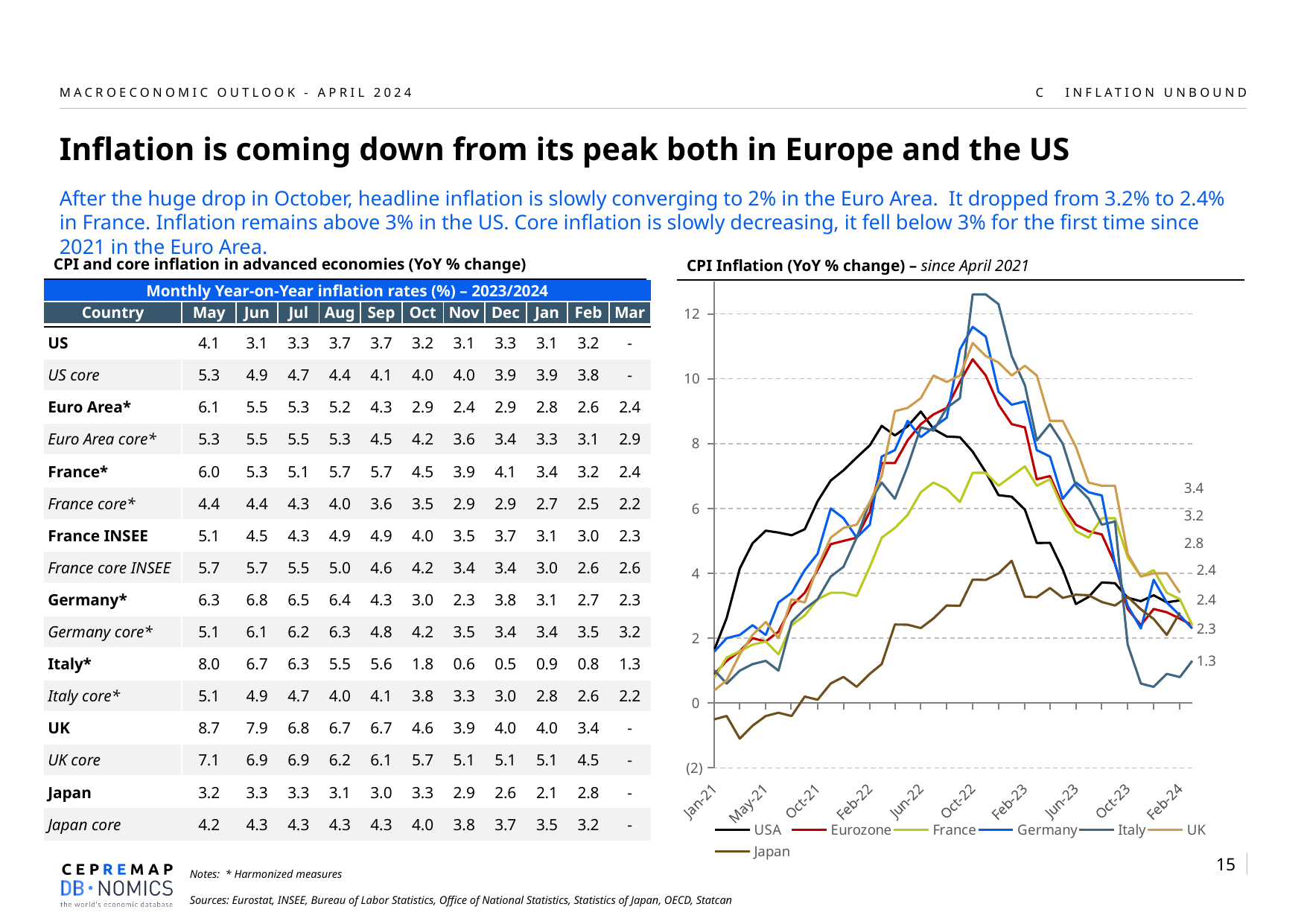
What kind of chart is the 'CPI Inflation (YoY % change) – since April 2021' chart? line chart In the CPI Inflation line chart, is the peak value of the Italy line greater or less than 12? greater What is the highest end-of-line value labelled at the right edge of the CPI Inflation line chart? 3.4 Which series in the CPI Inflation line chart ends at the labelled value 1.3? Italy In the CPI Inflation line chart, what is the lowest end-of-line value labelled at the right edge? 1.3 Which series in the CPI Inflation line chart reaches the highest peak? Italy What is the lowest tick value shown on the y axis of the CPI Inflation line chart? (2) How many series does the legend of the CPI Inflation line chart list? 7 In the CPI Inflation line chart, does the UK line rise or fall between Oct-22 and Feb-24? fall Which series in the CPI Inflation line chart has the lowest value at Jan-21? Japan In the CPI Inflation line chart, is the Japan value at Jan-21 greater or less than 0? less In the CPI Inflation line chart, is the USA value at Oct-22 greater or less than 10? less